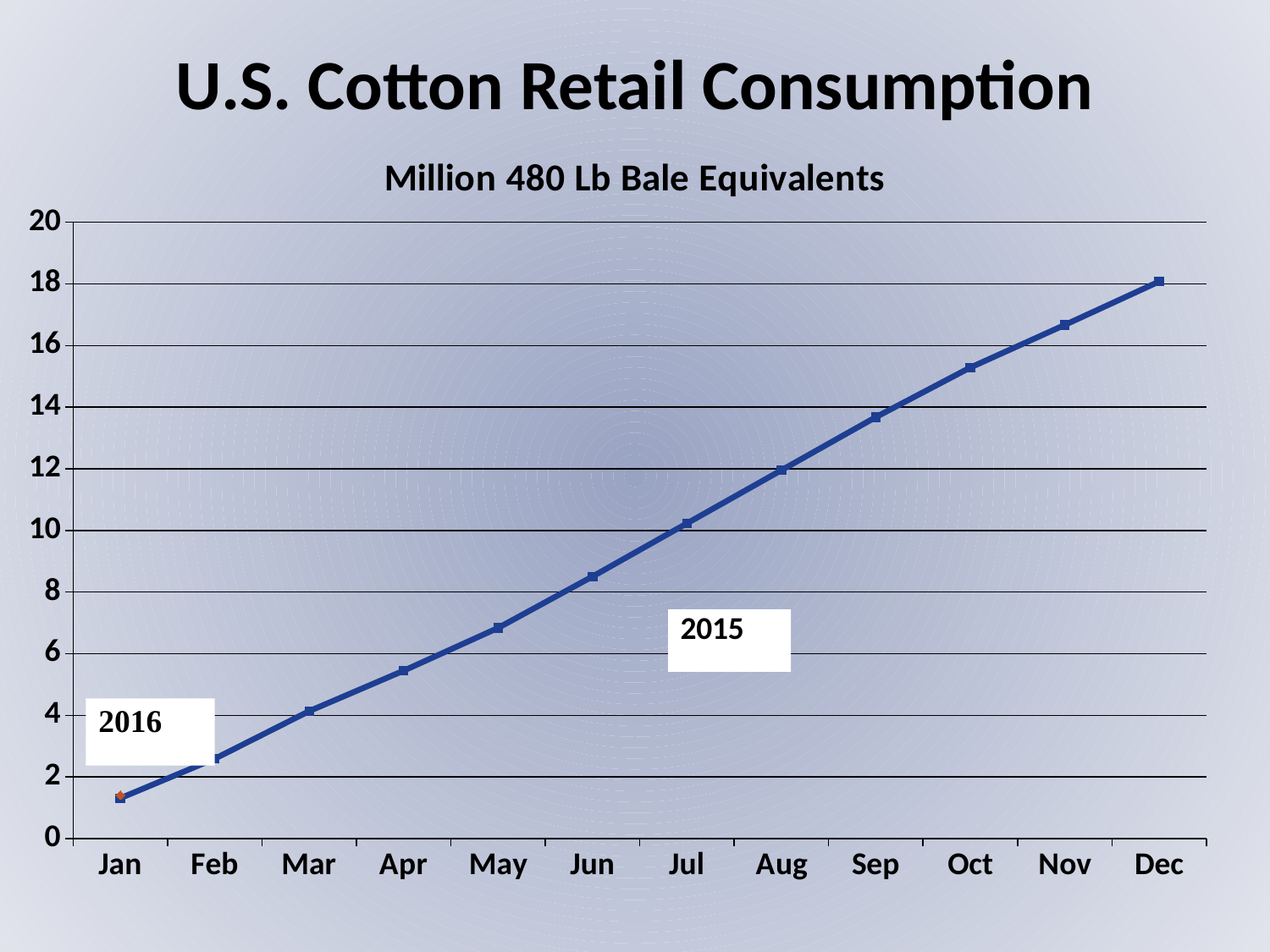
What kind of chart is shown on the slide? line chart Which is larger, the value for Oct or the value for Jun? Oct Do the values rise or fall from Jan to Dec? rise What is the title of the chart? U.S. Cotton Retail Consumption Is the value for Apr greater or less than 6? less How many months are plotted along the x axis? 12 Is the value for May greater or less than 6? greater Is the value for Nov greater or less than 16? greater What unit is given in the chart's subtitle? Million 480 Lb Bale Equivalents Which month has the lowest value? Jan Which month has the highest value? Dec